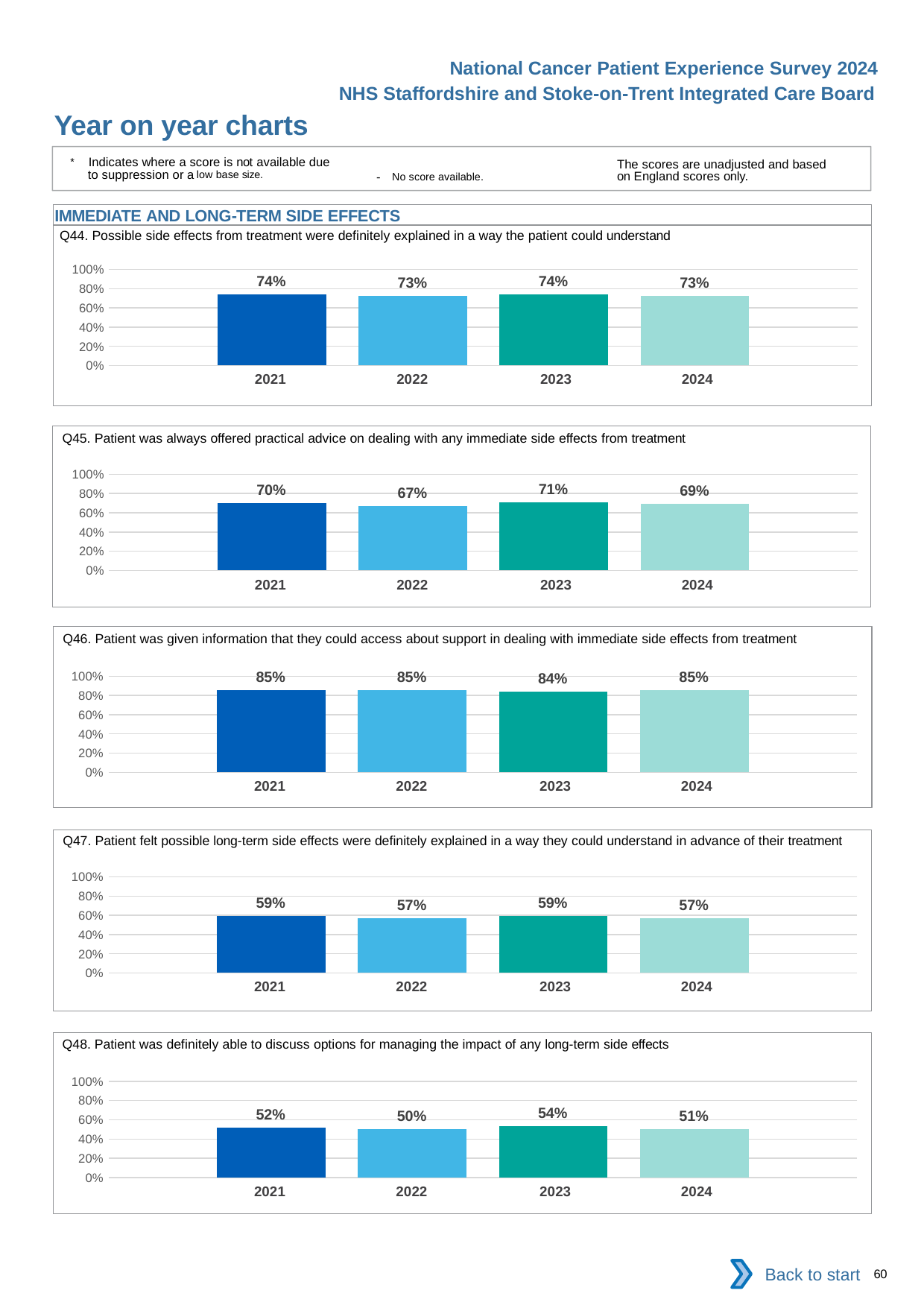
What kind of chart is the Q46 chart? bar chart How many years are shown on the x axis of the Q44 chart? 4 In the Q44 chart, what is the value for 2024? 73% In the Q45 chart, what is the difference between the 2023 value and the 2022 value? 4% In the Q46 chart, what is the value for 2023? 84% In the Q48 chart, which is larger, the value for 2023 or the value for 2024? 2023 In the Q45 chart, which year has the lowest value? 2022 In the Q48 chart, what is the value for 2021? 52% In the Q47 chart, what is the difference between the 2021 value and the 2022 value? 2% In the Q45 chart, which year has the highest value? 2023 In the Q47 chart, is the value for 2024 greater or less than 60%? less How many charts are shown on the slide? 5